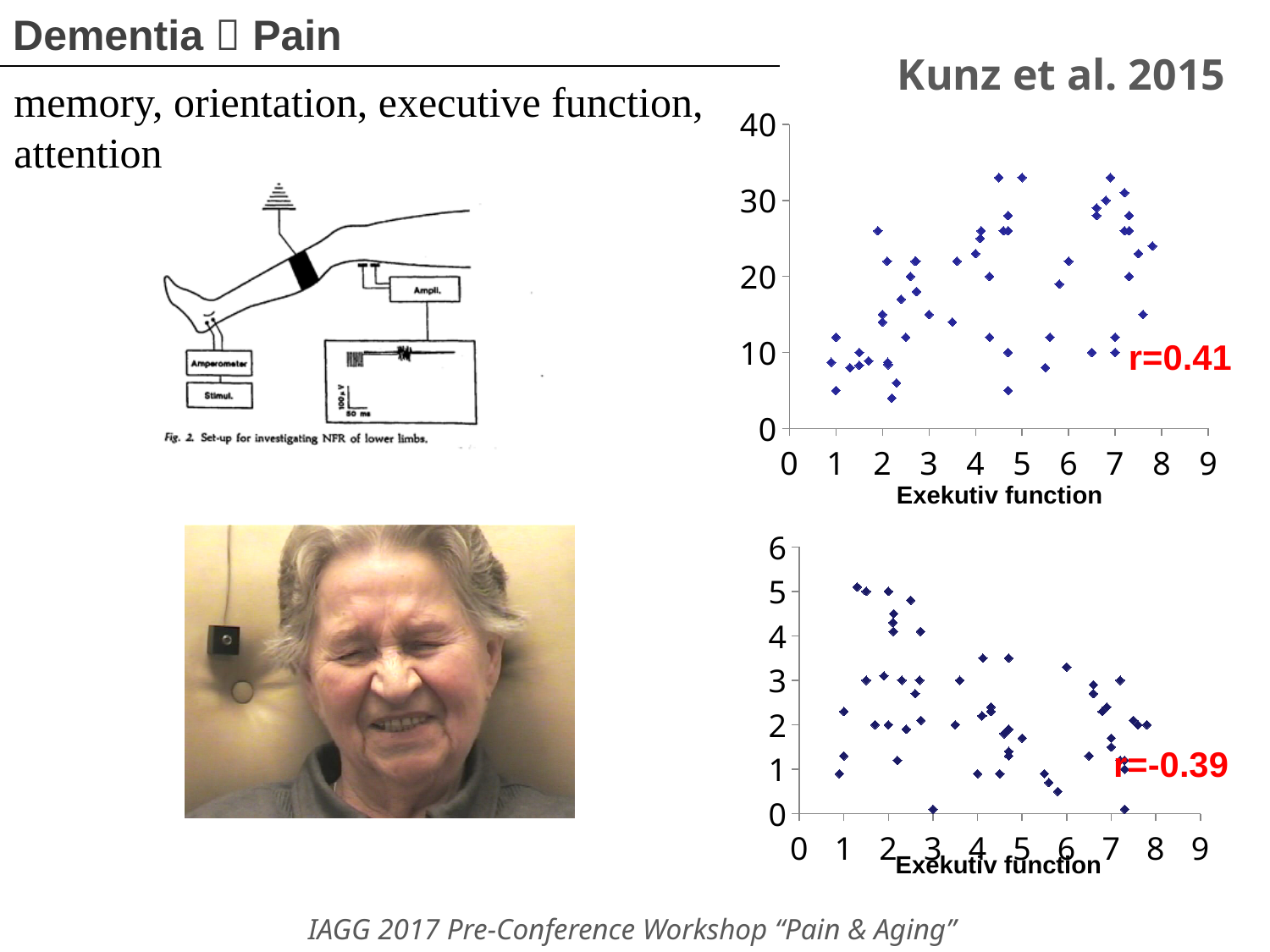
In the top chart (r=0.41), do the values tend to rise or fall as Exekutiv function increases along the x axis? rise What correlation coefficient is printed on the bottom chart on the right? r=-0.39 What kind of chart is the top chart on the right (with r=0.41)? scatter plot What kind of chart is the bottom chart on the right (with r=-0.39)? scatter plot What correlation coefficient is printed on the top chart on the right? r=0.41 In the bottom chart (r=-0.39), do the values tend to rise or fall as Exekutiv function increases along the x axis? fall